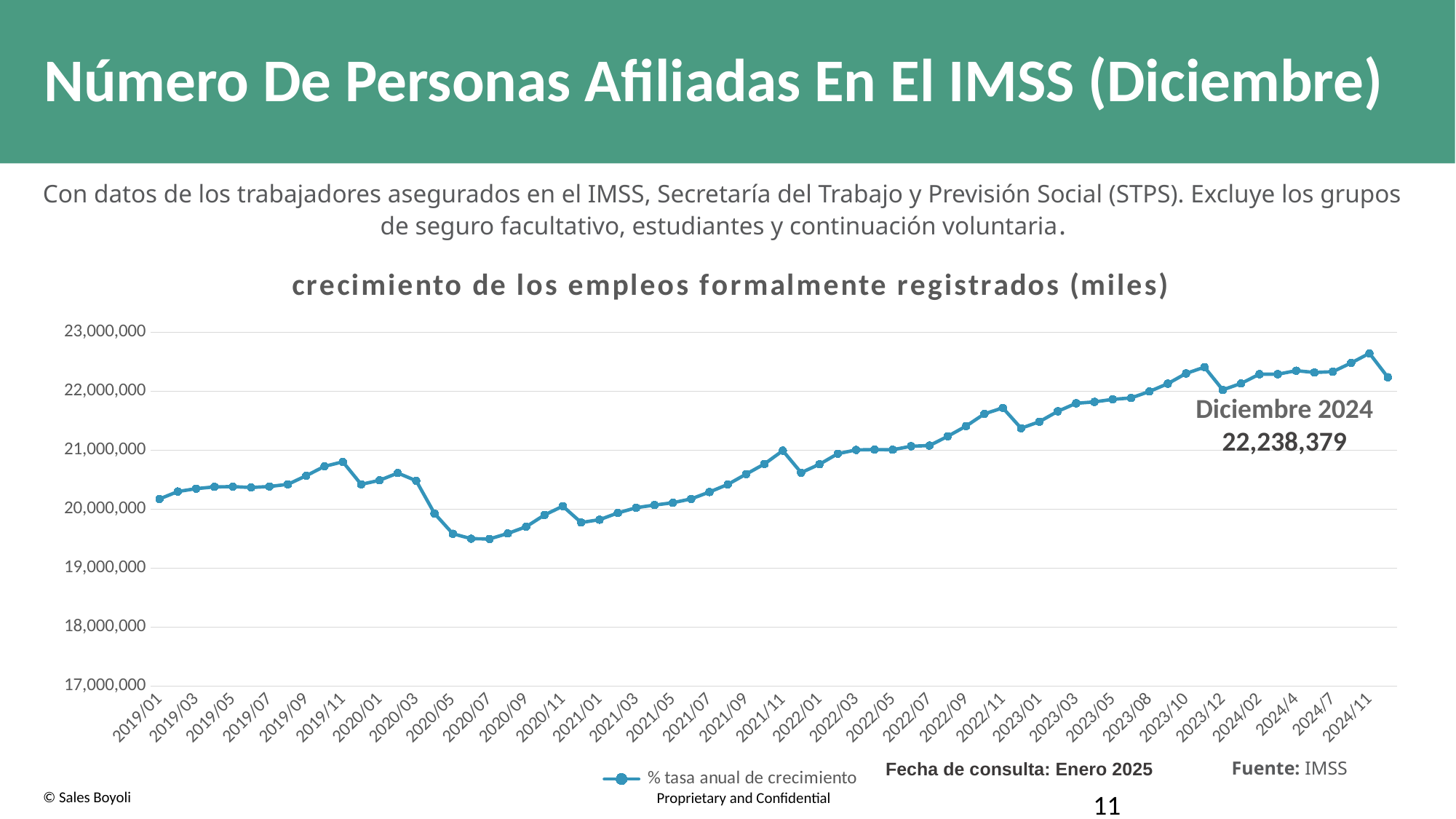
Which is larger, the value for 2019/11 or the value for 2020/07? 2019/11 What is the legend entry for the plotted series? % tasa anual de crecimiento What value is printed on the chart for Diciembre 2024? 22,238,379 Is the value for 2024/11 greater or less than 22,000,000? greater Is the value for 2022/11 greater or less than 21,000,000? greater Overall, do the values rise or fall from 2019/01 to 2024/11? rise How many series does the legend list? 1 Is the value for 2019/01 greater or less than 21,000,000? less What kind of chart is shown on the slide? line chart In which year does the line reach its lowest point? 2020 Which month has the highest value on the chart? 2024/11